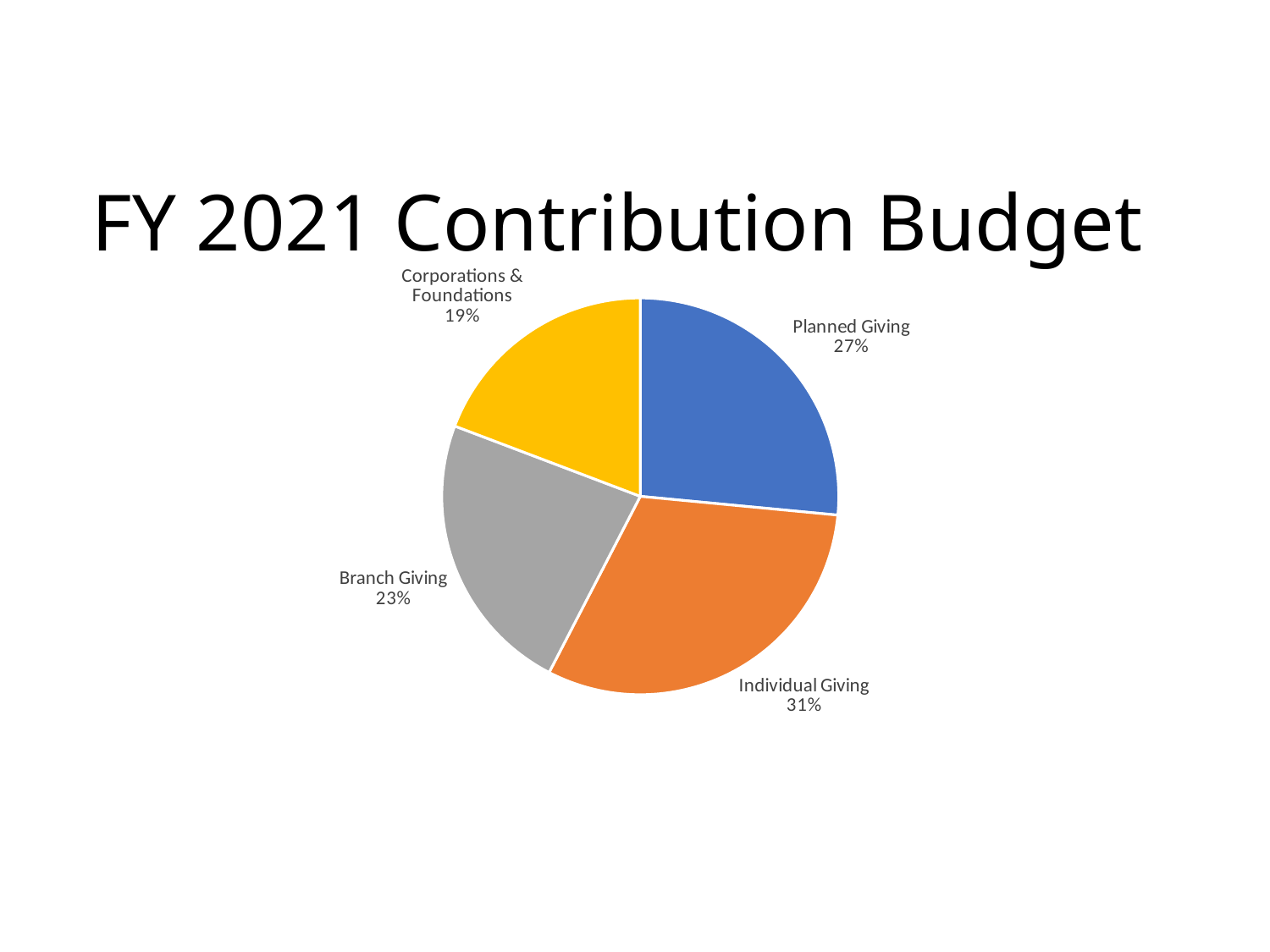
What colour is the Individual Giving slice? Orange What is the difference in percentage points between Individual Giving and Corporations & Foundations? 12 What share of the FY 2021 Contribution Budget is Corporations & Foundations? 19% What share of the FY 2021 Contribution Budget is Individual Giving? 31% What is the difference in percentage points between Planned Giving and Branch Giving? 4 What share of the FY 2021 Contribution Budget is Branch Giving? 23% Which is larger, the share for Planned Giving or the share for Branch Giving? Planned Giving Which category has the smallest share of the FY 2021 Contribution Budget? Corporations & Foundations Which category has the largest share of the FY 2021 Contribution Budget? Individual Giving How many categories are shown in the pie chart? 4 What type of chart is shown on the slide? Pie chart